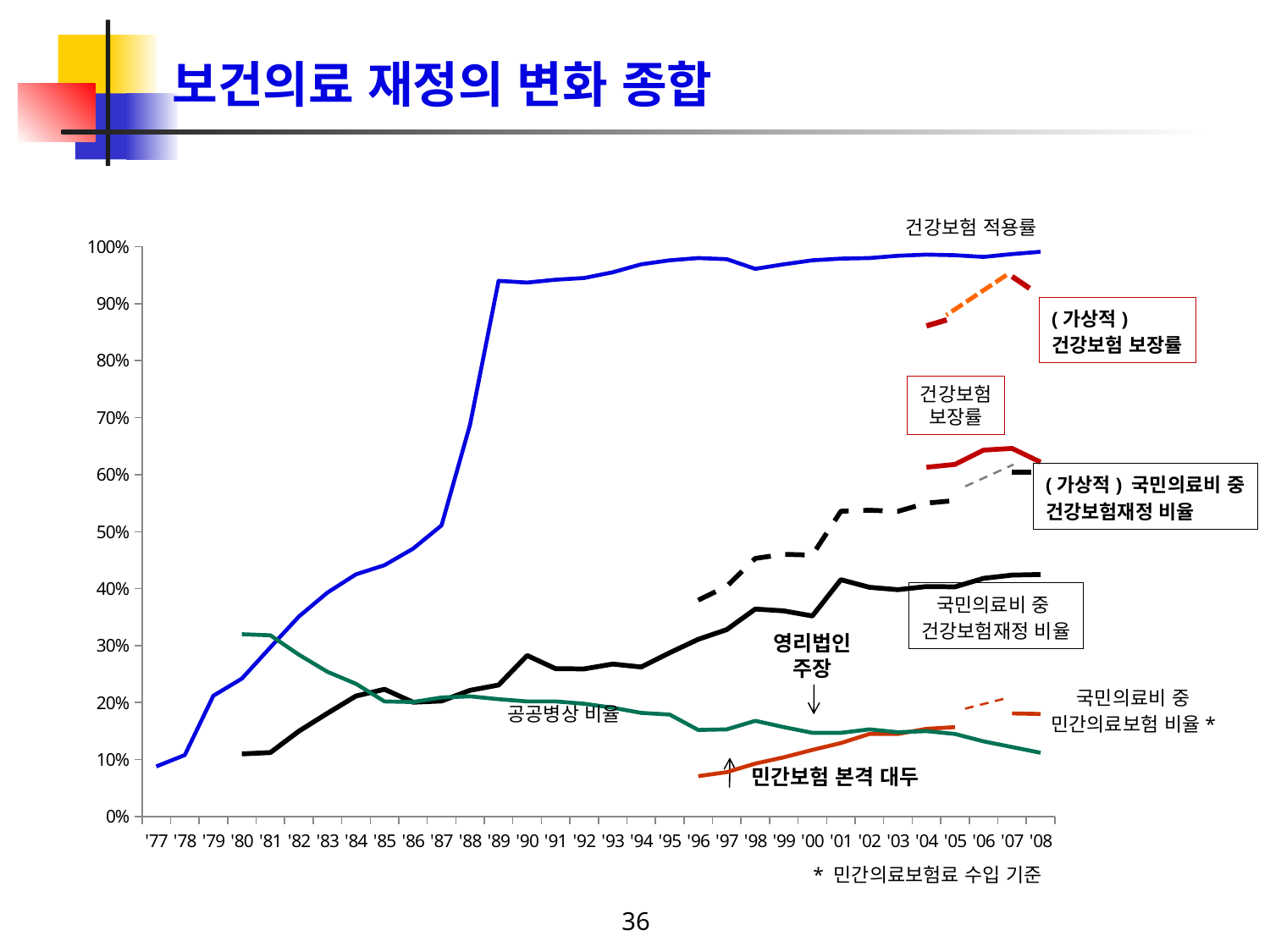
Which series has the highest value in '08? 건강보험 적용률 Is the value of 건강보험 적용률 in '89 greater or less than 90%? greater What is the title of the slide? 보건의료 재정의 변화 종합 Is the value of 건강보험 보장률 in '06 greater or less than 60%? greater How many years are labelled on the x axis? 32 Does the 건강보험 적용률 line rise or fall from '77 to '08? rise Is the value of 공공병상 비율 in '08 greater or less than 20%? less In '80, which is higher: 공공병상 비율 or 국민의료비 중 건강보험재정 비율? 공공병상 비율 What kind of chart is shown on the slide? line chart Does the 공공병상 비율 line rise or fall from '80 to '08? fall